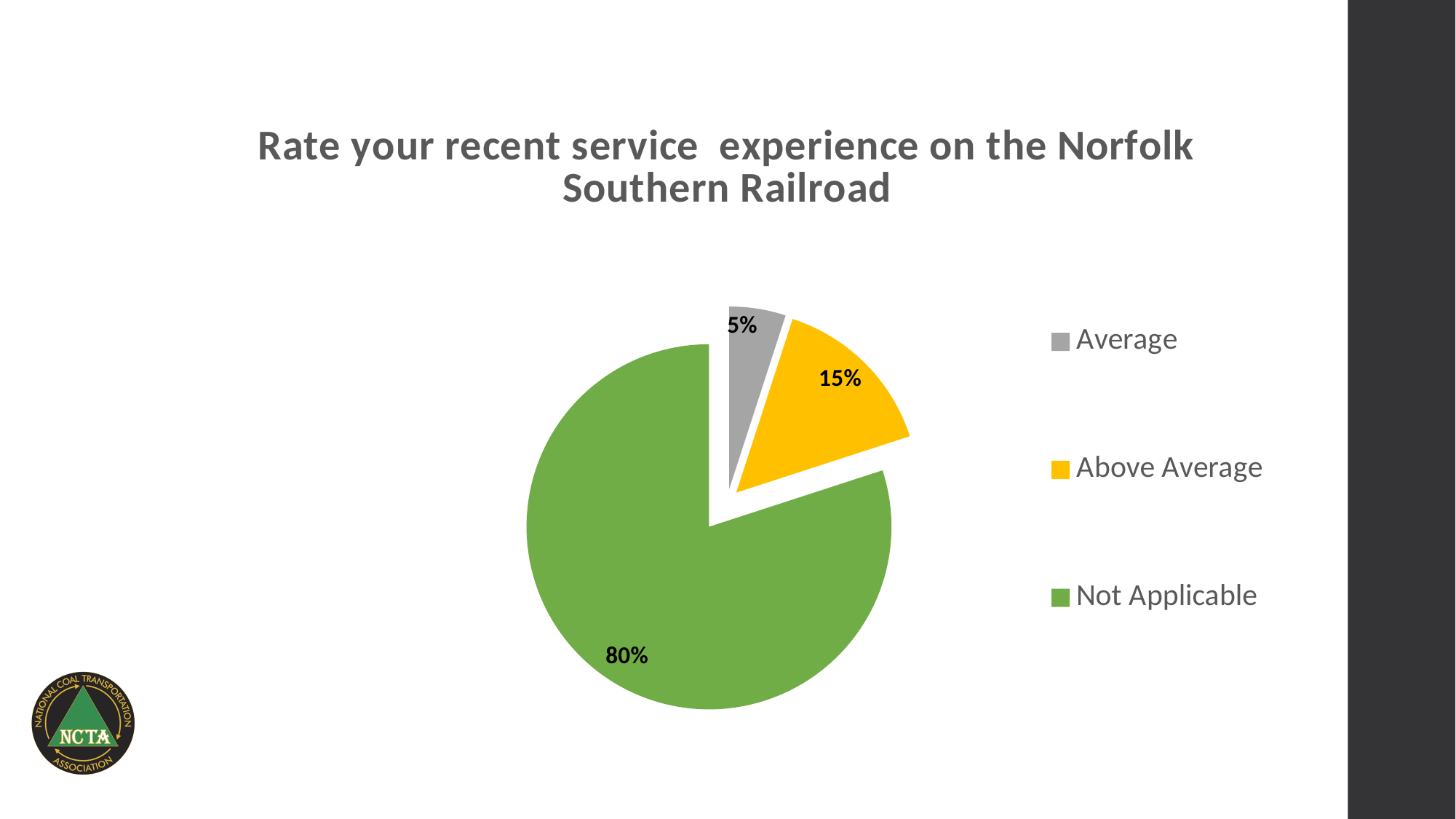
What share of the pie is labelled Above Average? 15% What kind of chart is shown on the slide? pie chart What is the difference in percentage points between the Above Average slice and the Average slice? 10 What share of the pie is labelled Not Applicable? 80% What share of the pie is labelled Average? 5% What colour is the Above Average slice in the pie chart? yellow How many categories does the pie chart show? 3 What is the title of the chart? Rate your recent service experience on the Norfolk Southern Railroad Which category has the smallest slice of the pie? Average What is the difference in percentage points between the Not Applicable slice and the Above Average slice? 65 Which category has the largest slice of the pie? Not Applicable Which is larger, the Above Average slice or the Average slice? Above Average